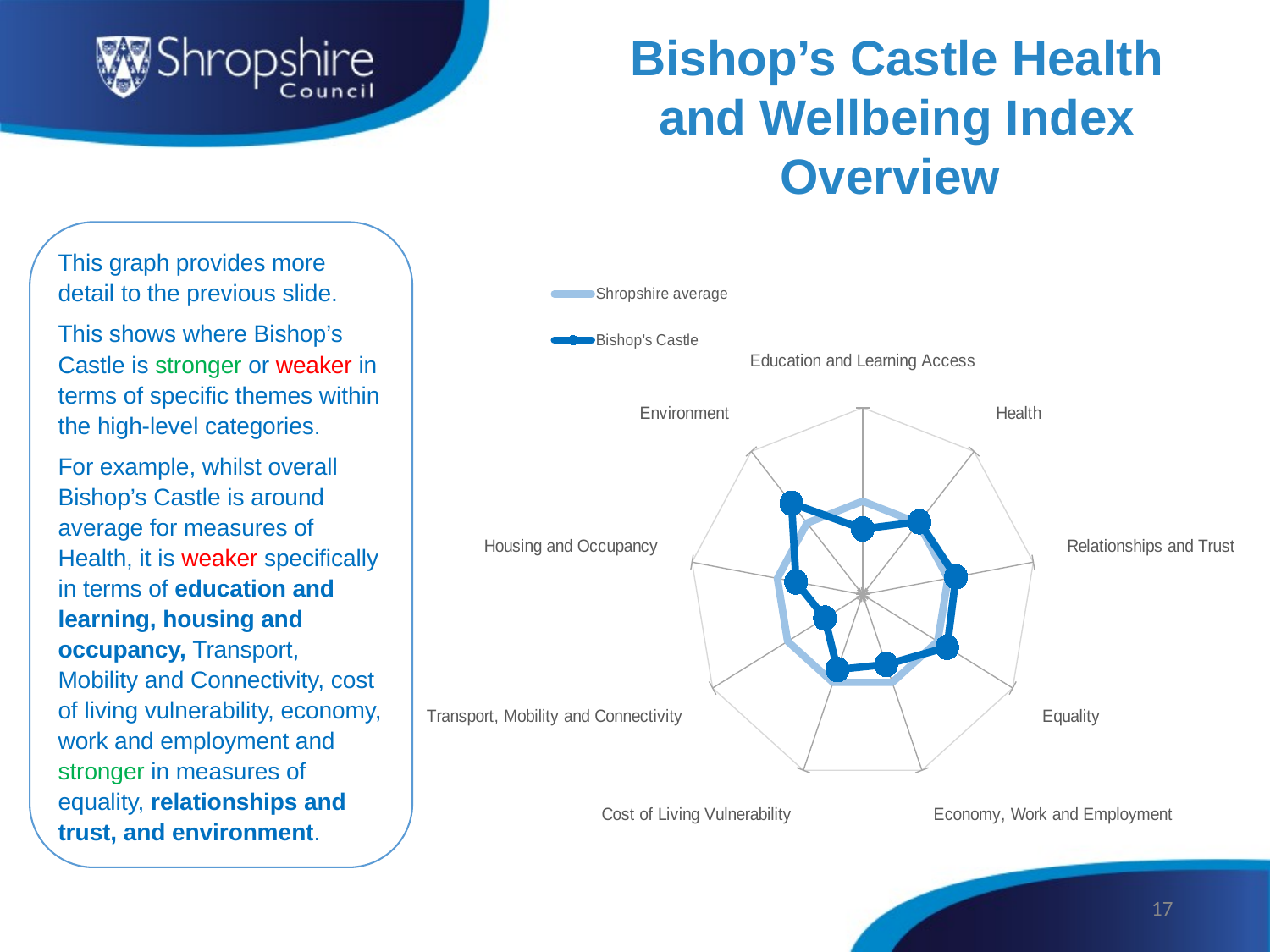
Which series is drawn with the darker blue line with markers? Bishop's Castle For Environment, which series has the larger value, Shropshire average or Bishop's Castle? Bishop's Castle How many series does the chart legend list? 2 For Housing and Occupancy, which series has the larger value, Shropshire average or Bishop's Castle? Shropshire average What are the two series named in the chart legend? Shropshire average and Bishop's Castle For Education and Learning Access, which series has the larger value, Shropshire average or Bishop's Castle? Shropshire average What kind of chart is shown on the slide? Radar chart Which category is labelled at the top of the radar chart? Education and Learning Access How many categories (axes) does the radar chart have? 9